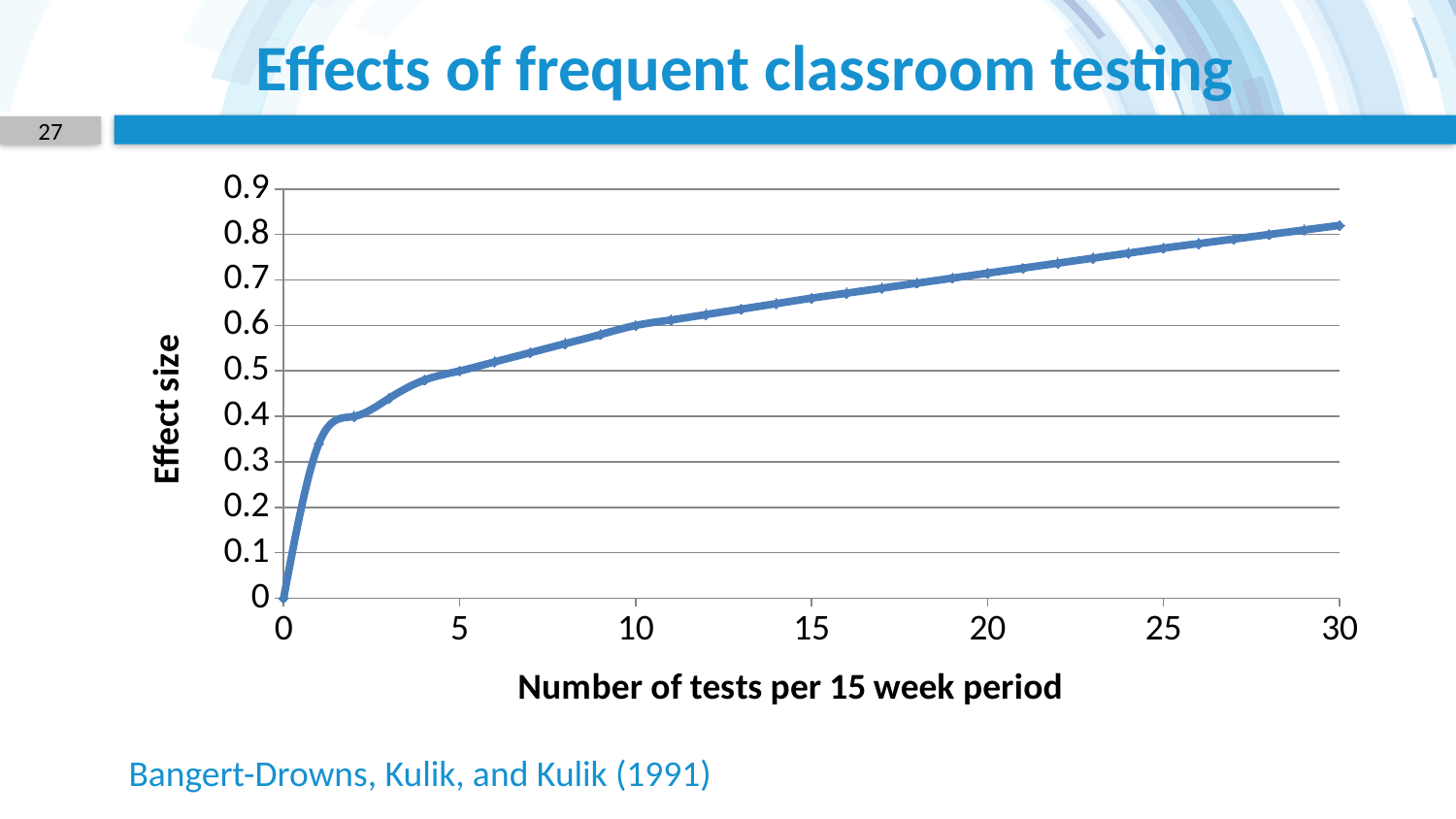
What kind of chart is shown on the slide? line chart At which number of tests per 15 week period is the effect size highest? 30 Is the effect size at 15 tests per 15 week period greater or less than 0.6? greater What is the effect size at 10 tests per 15 week period? 0.6 Is the effect size at 25 tests per 15 week period greater or less than 0.8? less What is the effect size when the number of tests per 15 week period is 0? 0 Does the effect size rise or fall as the number of tests per 15 week period increases? rises Which has the larger effect size: 10 tests or 20 tests per 15 week period? 20 tests What is the effect size at 5 tests per 15 week period? 0.5 What is the label of the vertical axis? Effect size Is the effect size at 30 tests per 15 week period greater or less than 0.8? greater